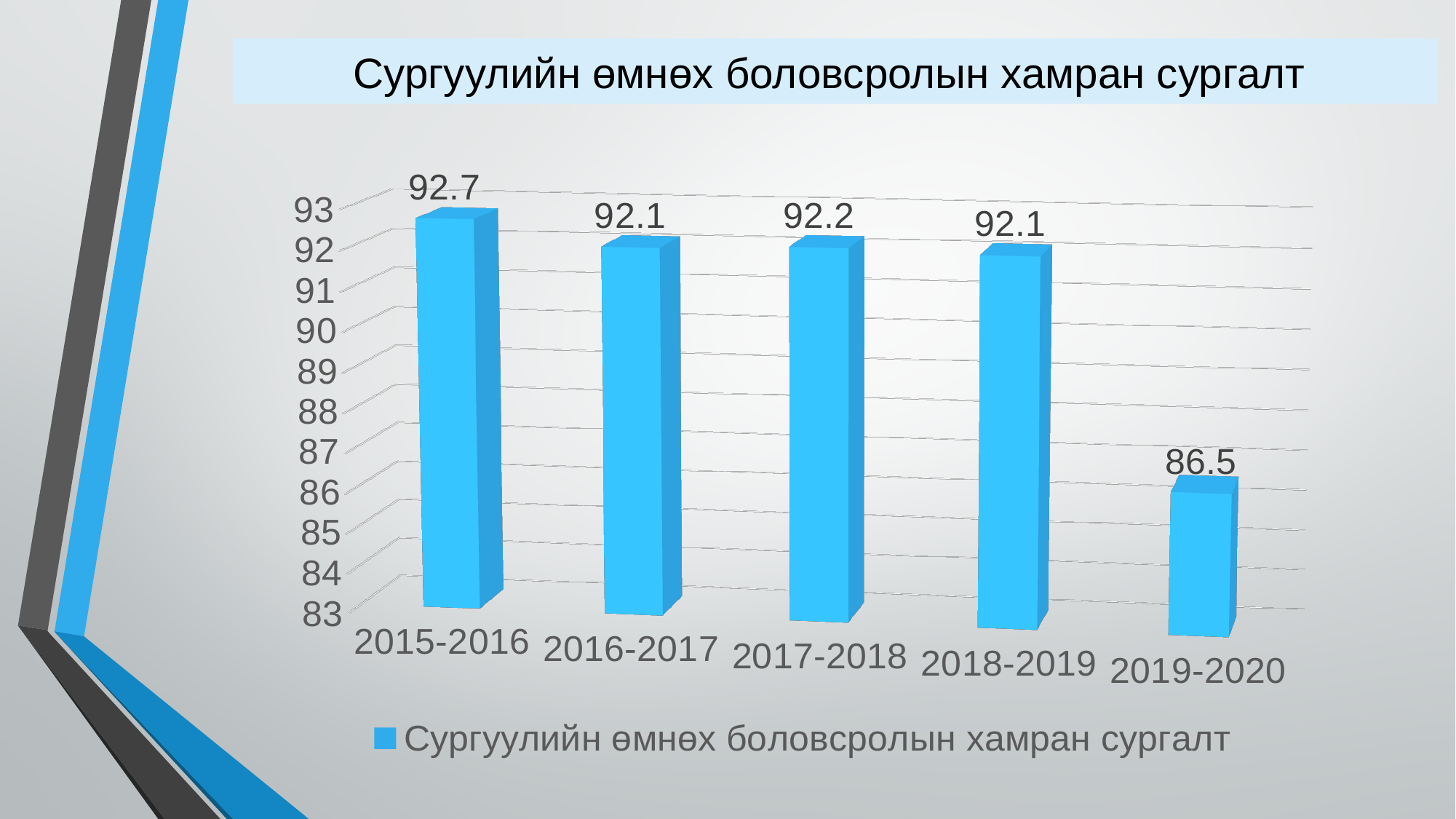
What is the value for 2015-2016? 92.7 What is the difference between the values for 2015-2016 and 2019-2020? 6.2 Is the value for 2019-2020 greater or less than 90? less Which year has the lowest value? 2019-2020 What is the title of the chart? Сургуулийн өмнөх боловсролын хамран сургалт What kind of chart is shown on the slide? bar chart What is the value for 2019-2020? 86.5 Which year has the highest value? 2015-2016 How many years are shown on the x axis? 5 What is the difference between the values for 2017-2018 and 2016-2017? 0.1 Which is larger, the value for 2018-2019 or the value for 2019-2020? 2018-2019 What is the value for 2017-2018? 92.2